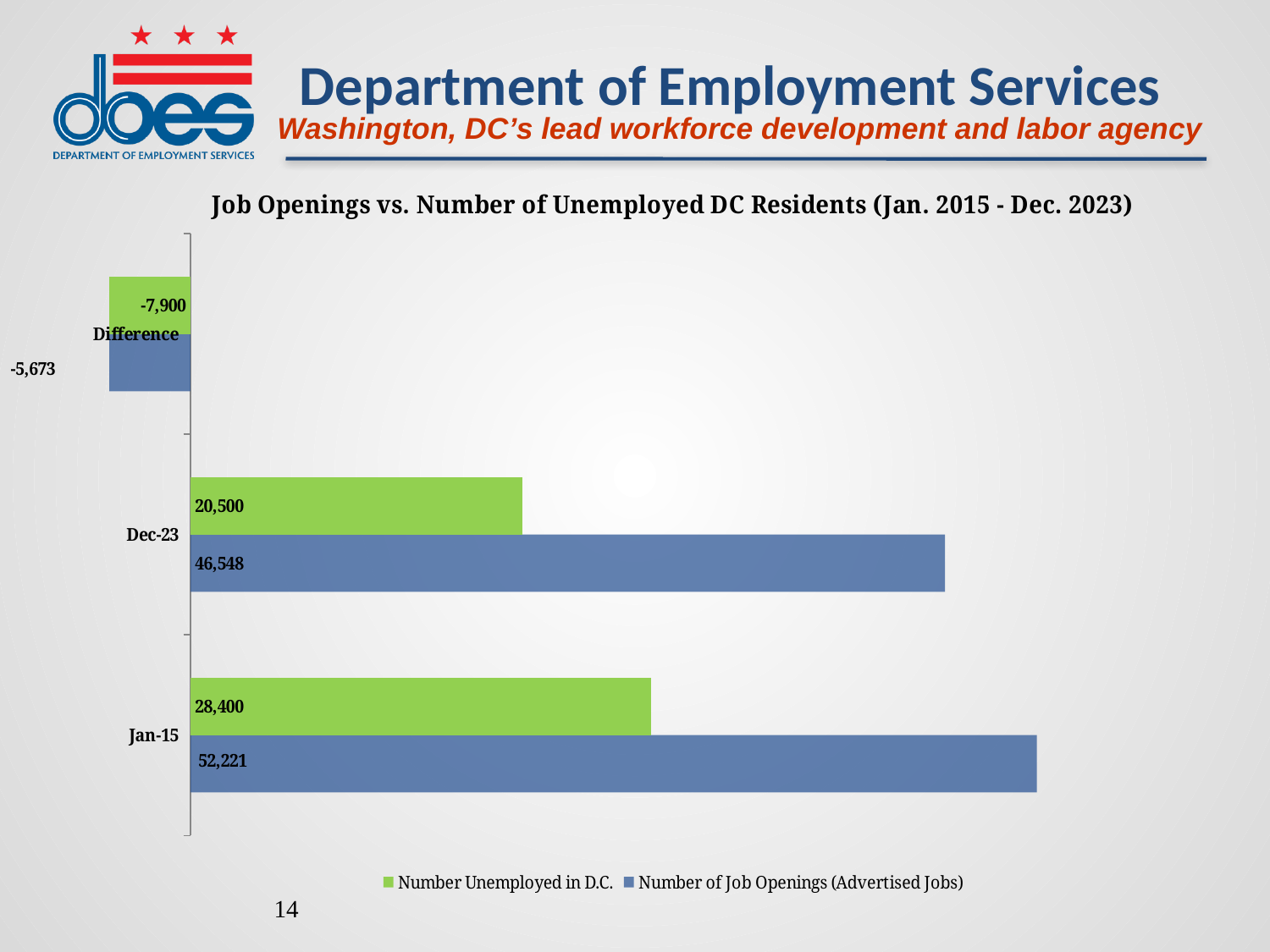
What is the Number Unemployed in D.C. for Jan-15? 28,400 How many series does the legend list? 2 What is the difference between the Number of Job Openings (Advertised Jobs) in Jan-15 and in Dec-23? 5,673 What is the Number Unemployed in D.C. value shown for the Difference category? -7,900 What is the Number of Job Openings (Advertised Jobs) for Jan-15? 52,221 How many categories are shown on the vertical axis of the chart? 3 Which is larger for Dec-23: the Number Unemployed in D.C. or the Number of Job Openings (Advertised Jobs)? Number of Job Openings (Advertised Jobs) Which colour represents the Number Unemployed in D.C. series? Green What is the Number Unemployed in D.C. for Dec-23? 20,500 What kind of chart is shown on the slide? Bar chart What is the title of the chart? Job Openings vs. Number of Unemployed DC Residents (Jan. 2015 - Dec. 2023) What is the Number of Job Openings (Advertised Jobs) value shown for the Difference category? -5,673